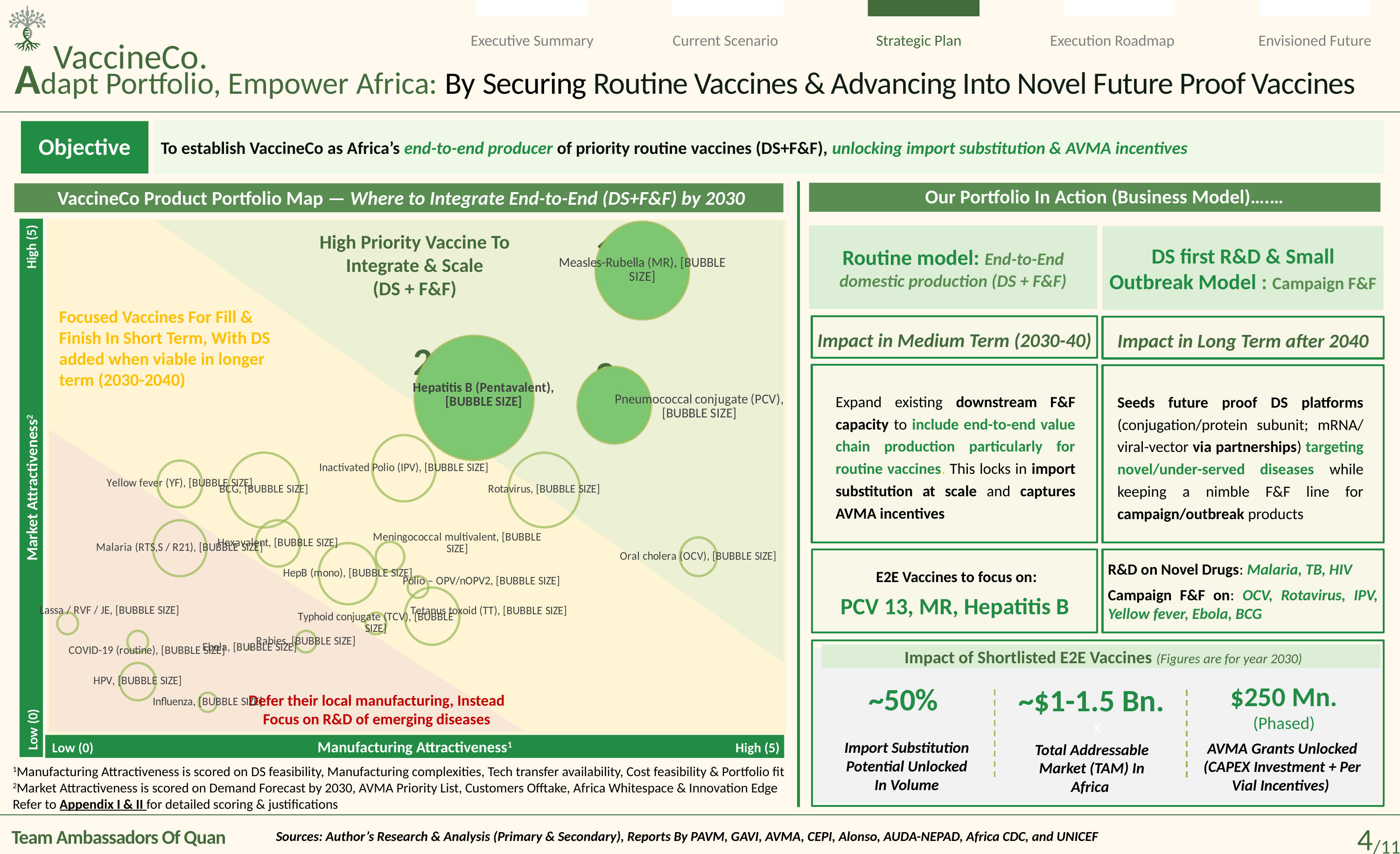
What is the label of the horizontal axis in the VaccineCo Product Portfolio Map? Manufacturing Attractiveness What is the range of the Market Attractiveness axis in the VaccineCo Product Portfolio Map? Low (0) to High (5) In the VaccineCo Product Portfolio Map, which has higher Market Attractiveness: Measles-Rubella (MR) or Influenza? Measles-Rubella (MR) In the VaccineCo Product Portfolio Map, which vaccine bubble is positioned furthest to the right on the Manufacturing Attractiveness axis? Oral cholera (OCV) In the VaccineCo Product Portfolio Map, which vaccine bubble is positioned highest on the Market Attractiveness axis? Measles-Rubella (MR) In the VaccineCo Product Portfolio Map, which vaccine bubble is positioned furthest to the left on the Manufacturing Attractiveness axis? Lassa / RVF / JE How many bubbles in the VaccineCo Product Portfolio Map are shown as solid filled green (the high priority vaccines)? 3 In the VaccineCo Product Portfolio Map, which vaccine bubble is positioned lowest on the Market Attractiveness axis? Influenza In the VaccineCo Product Portfolio Map, which has higher Manufacturing Attractiveness: Hepatitis B (Pentavalent) or Yellow fever (YF)? Hepatitis B (Pentavalent) What kind of chart is the VaccineCo Product Portfolio Map? Bubble chart In the VaccineCo Product Portfolio Map, which vaccine has the largest bubble? Hepatitis B (Pentavalent) How many vaccine bubbles are plotted in the VaccineCo Product Portfolio Map? 21